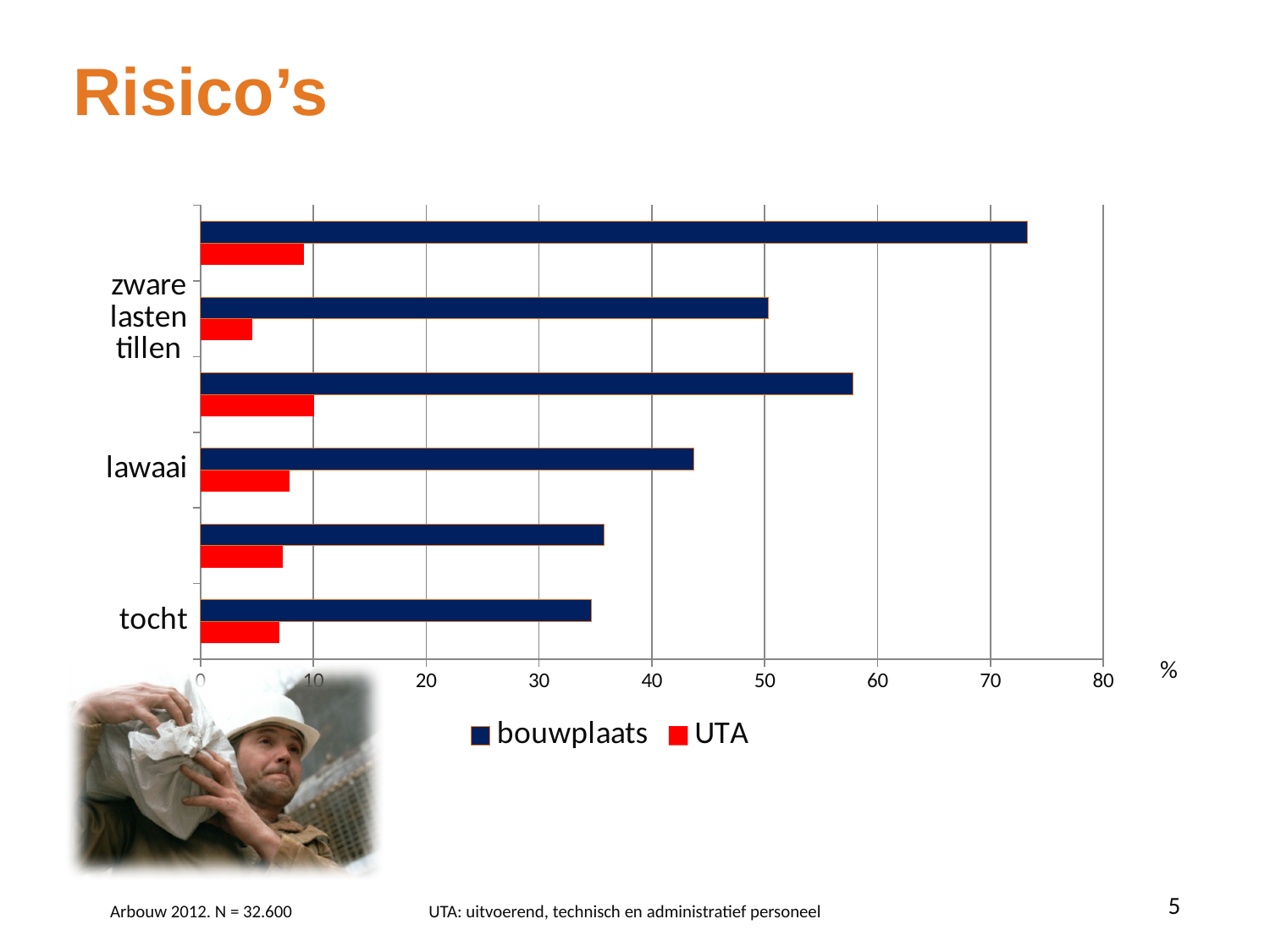
What are the two series named in the legend? bouwplaats and UTA For 'lawaai', which series has the larger value, bouwplaats or UTA? bouwplaats Is the bouwplaats value for 'zware lasten tillen' greater or less than 40? greater Among 'zware lasten tillen', 'lawaai' and 'tocht', which has the lowest bouwplaats value? tocht What kind of chart is shown on the slide? bar chart Is the UTA value for 'zware lasten tillen' greater or less than 10? less What unit is shown at the end of the horizontal axis? % How many categories (pairs of bars) are plotted in the chart? 6 How many series does the legend list? 2 Which has the higher bouwplaats value, 'lawaai' or 'tocht'? lawaai Is the bouwplaats value for 'tocht' greater or less than 40? less